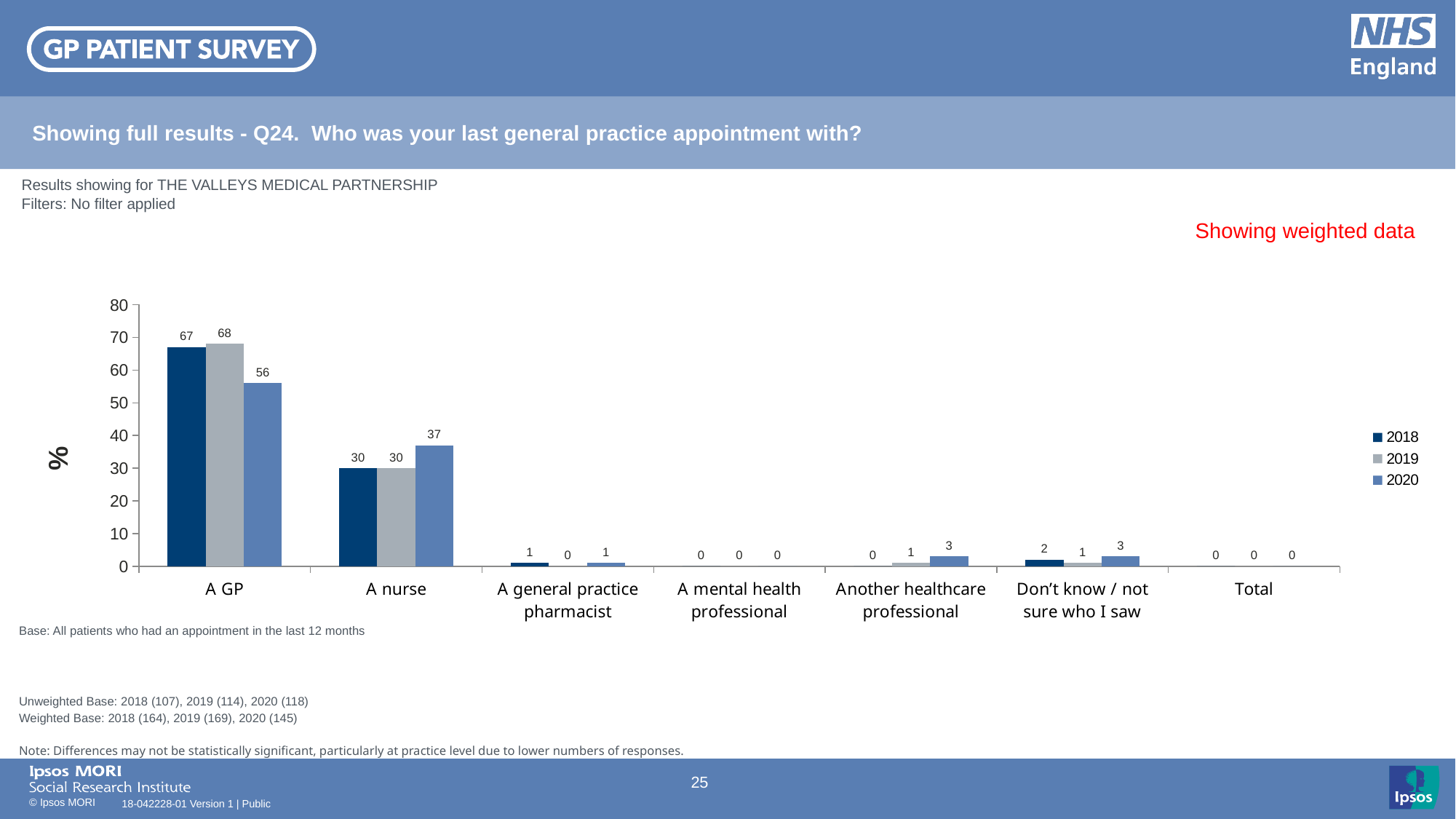
Which category has the highest value in 2018? A GP How many categories are shown on the x axis? 7 What label is shown on the y axis? % What is the difference between the 2019 and 2020 values for A GP? 12 What is the value for A GP in 2020? 56 How many series does the legend list? 3 What is the value for A nurse in 2019? 30 What kind of chart is shown on the slide? Bar chart What is the value for Another healthcare professional in 2020? 3 Which is larger for A nurse: the 2018 value or the 2020 value? 2020 Does the value for A GP rise or fall from 2019 to 2020? Fall What is the value for Don't know / not sure who I saw in 2018? 2